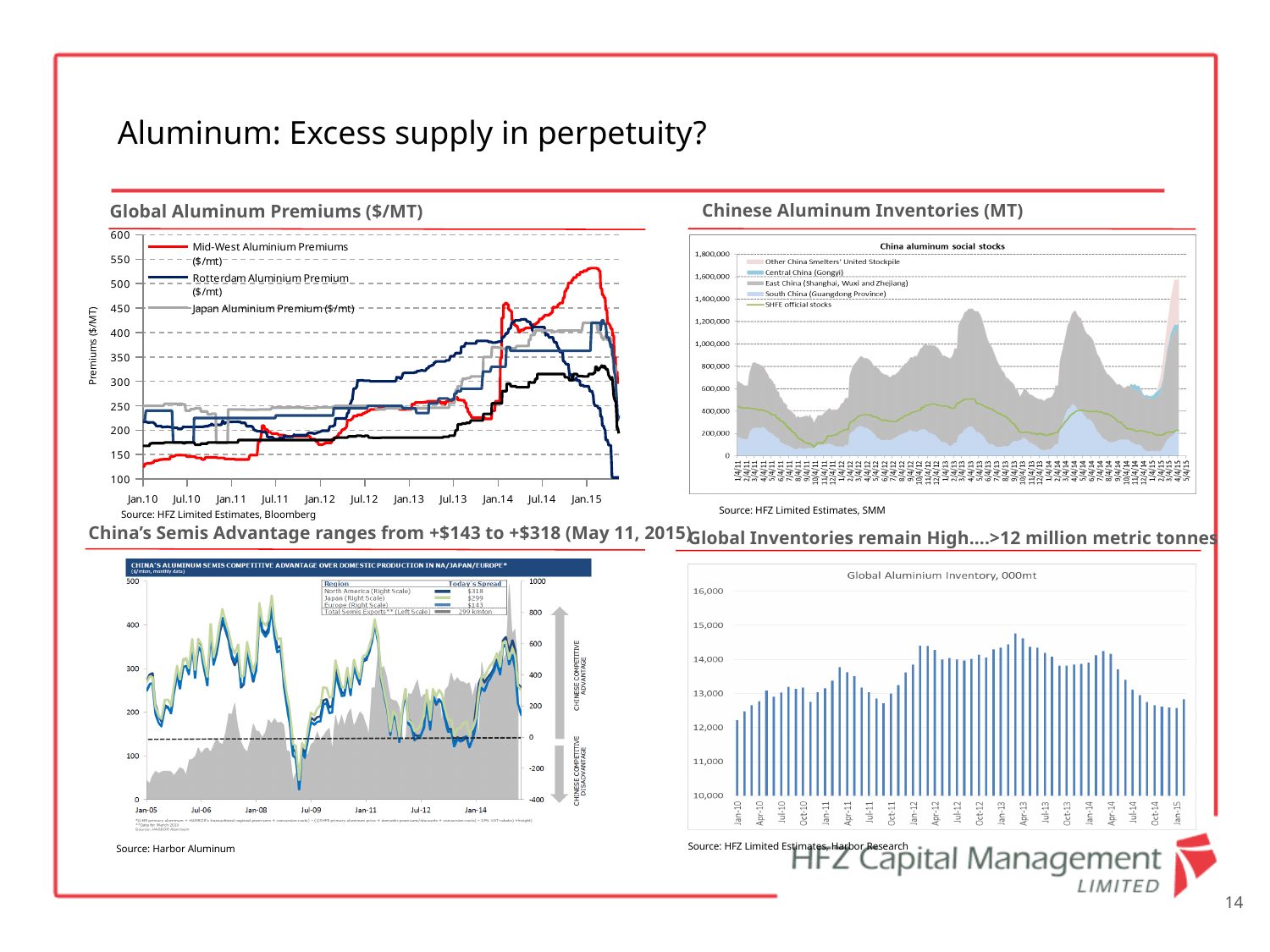
In the China's Aluminum Semis Competitive Advantage chart, what is Today's Spread for Europe? $143 In the China's Aluminum Semis Competitive Advantage chart, what is Today's Spread for North America? $318 In the Global Aluminum Premiums ($/MT) chart, is the Mid-West Aluminium Premium at Jan.10 greater or less than 200? less What kind of chart is the Global Aluminum Premiums ($/MT) chart? line chart In the Global Aluminium Inventory, 000mt chart, is the value for Apr-13 greater or less than 14,000? greater In the China's Aluminum Semis Competitive Advantage chart, which region has the lowest Today's Spread? Europe What kind of chart is the Global Aluminium Inventory, 000mt chart? bar chart How many series does the legend of the Chinese Aluminum Inventories (MT) chart list? 5 In the China's Aluminum Semis Competitive Advantage chart, what is the difference between Today's Spread for North America and for Europe? $175 In the Global Aluminium Inventory, 000mt chart, is the value for Jan-10 greater or less than 13,000? less In the Global Aluminium Inventory, 000mt chart, do the values rise or fall from Apr-13 to Jan-15? fall How many series does the legend of the Global Aluminum Premiums ($/MT) chart list? 3